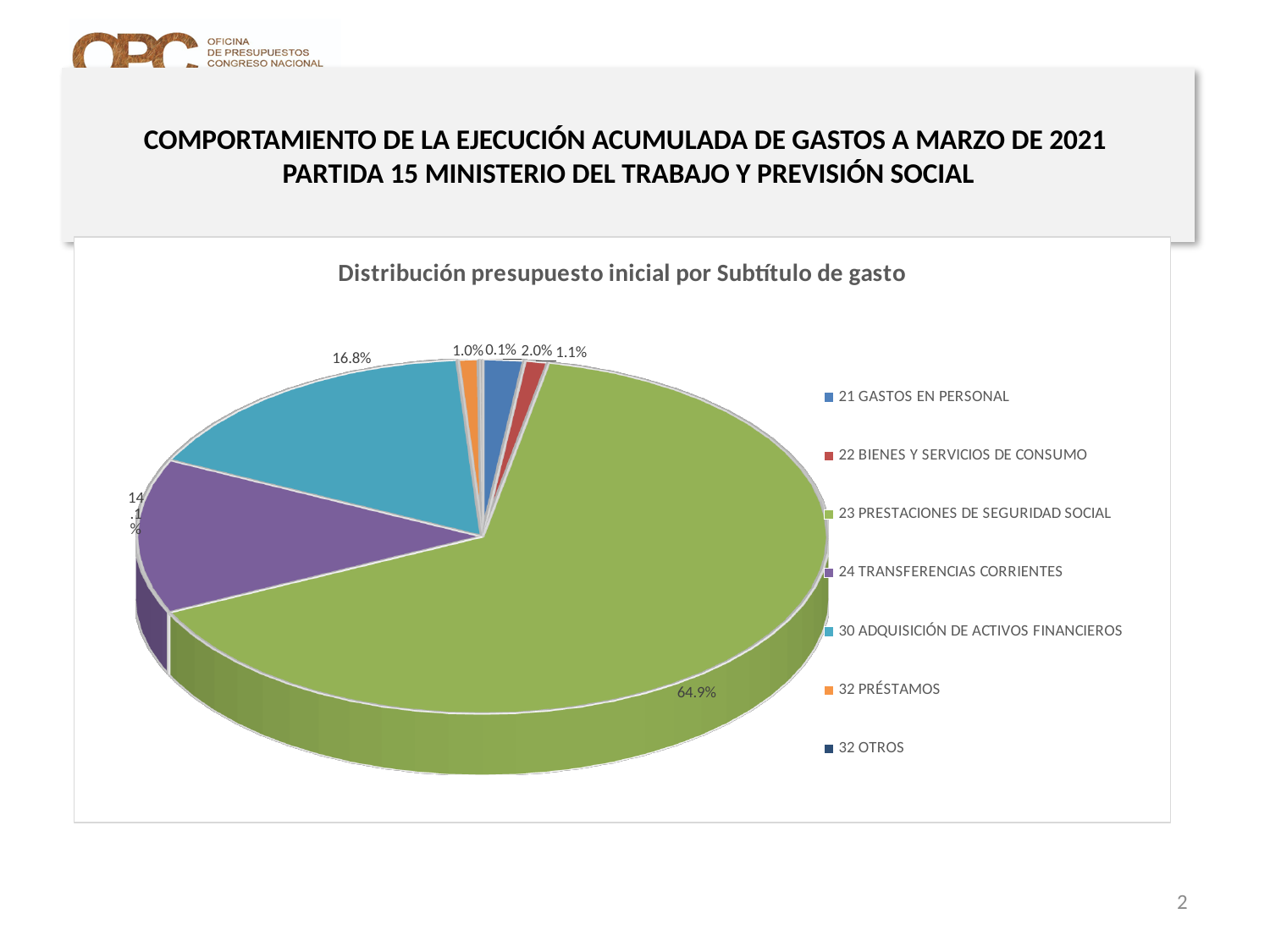
What share of the pie does 30 ADQUISICIÓN DE ACTIVOS FINANCIEROS represent? 16.8% What share of the pie does 23 PRESTACIONES DE SEGURIDAD SOCIAL represent? 64.9% What is the title of the chart? Distribución presupuesto inicial por Subtítulo de gasto What share of the pie does 24 TRANSFERENCIAS CORRIENTES represent? 14.1% Which is larger, the share for 30 ADQUISICIÓN DE ACTIVOS FINANCIEROS or for 24 TRANSFERENCIAS CORRIENTES? 30 ADQUISICIÓN DE ACTIVOS FINANCIEROS How many categories does the legend of the pie chart list? 7 What is the difference in percentage points between the share for 30 ADQUISICIÓN DE ACTIVOS FINANCIEROS and the share for 24 TRANSFERENCIAS CORRIENTES? 2.7 Which category has the smallest slice of the pie? 32 OTROS Which category has the largest slice of the pie? 23 PRESTACIONES DE SEGURIDAD SOCIAL What kind of chart is shown on the slide? Pie chart